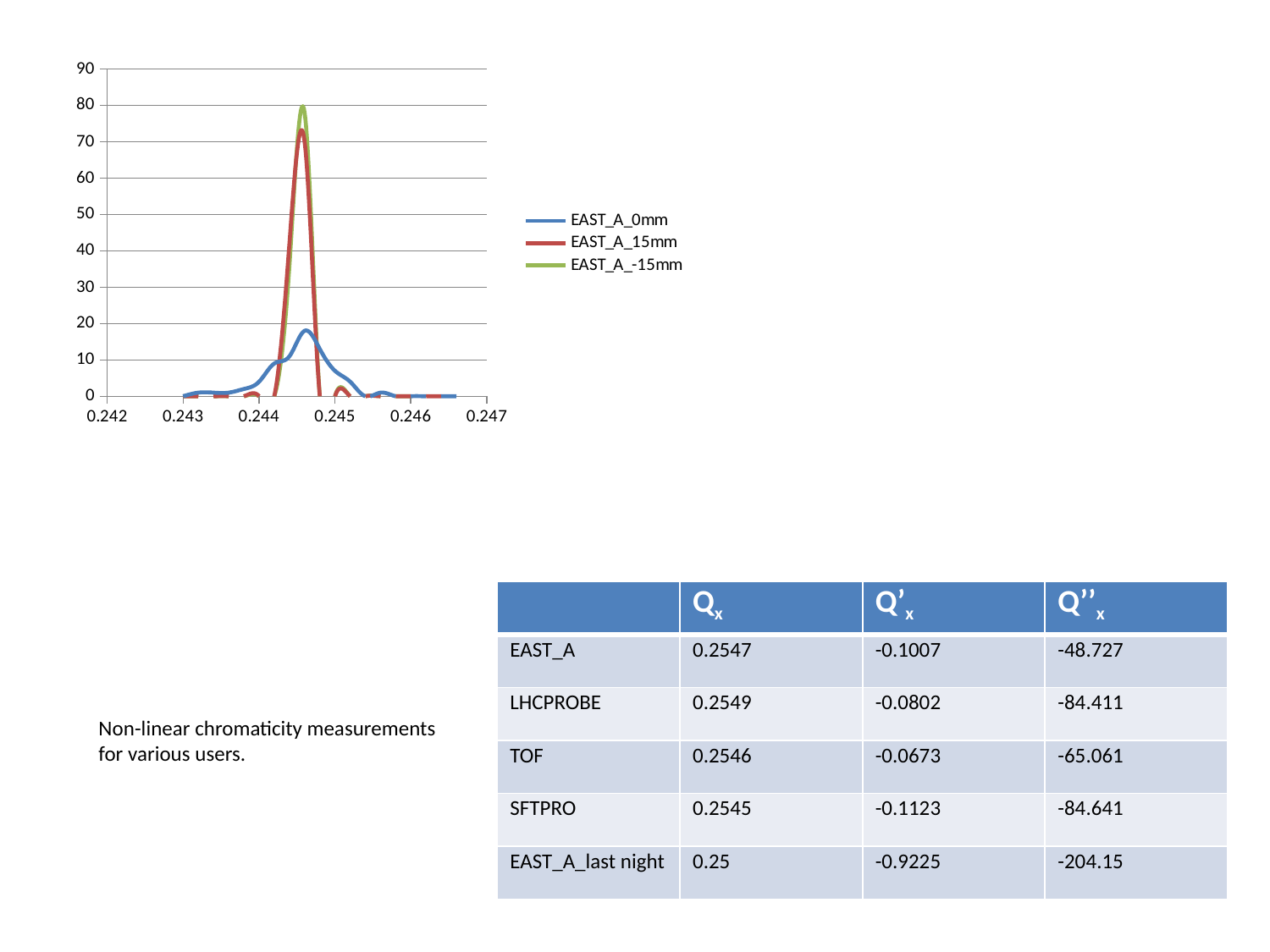
Is the peak value of EAST_A_15mm greater or less than 60? greater Which series has a higher peak, EAST_A_-15mm or EAST_A_15mm? EAST_A_-15mm Which series has the lowest peak value in the chart? EAST_A_0mm What colour is the EAST_A_15mm line in the chart? red Is the peak value of EAST_A_0mm greater or less than 30? less What kind of chart is shown on the slide? line chart What is the highest value labelled on the chart's y axis? 90 How many series does the chart's legend list? 3 How many tick labels are shown on the x axis of the chart? 6 Which series has a higher peak, EAST_A_15mm or EAST_A_0mm? EAST_A_15mm Which series reaches the highest peak value in the chart? EAST_A_-15mm Is the peak value of EAST_A_-15mm greater or less than 70? greater